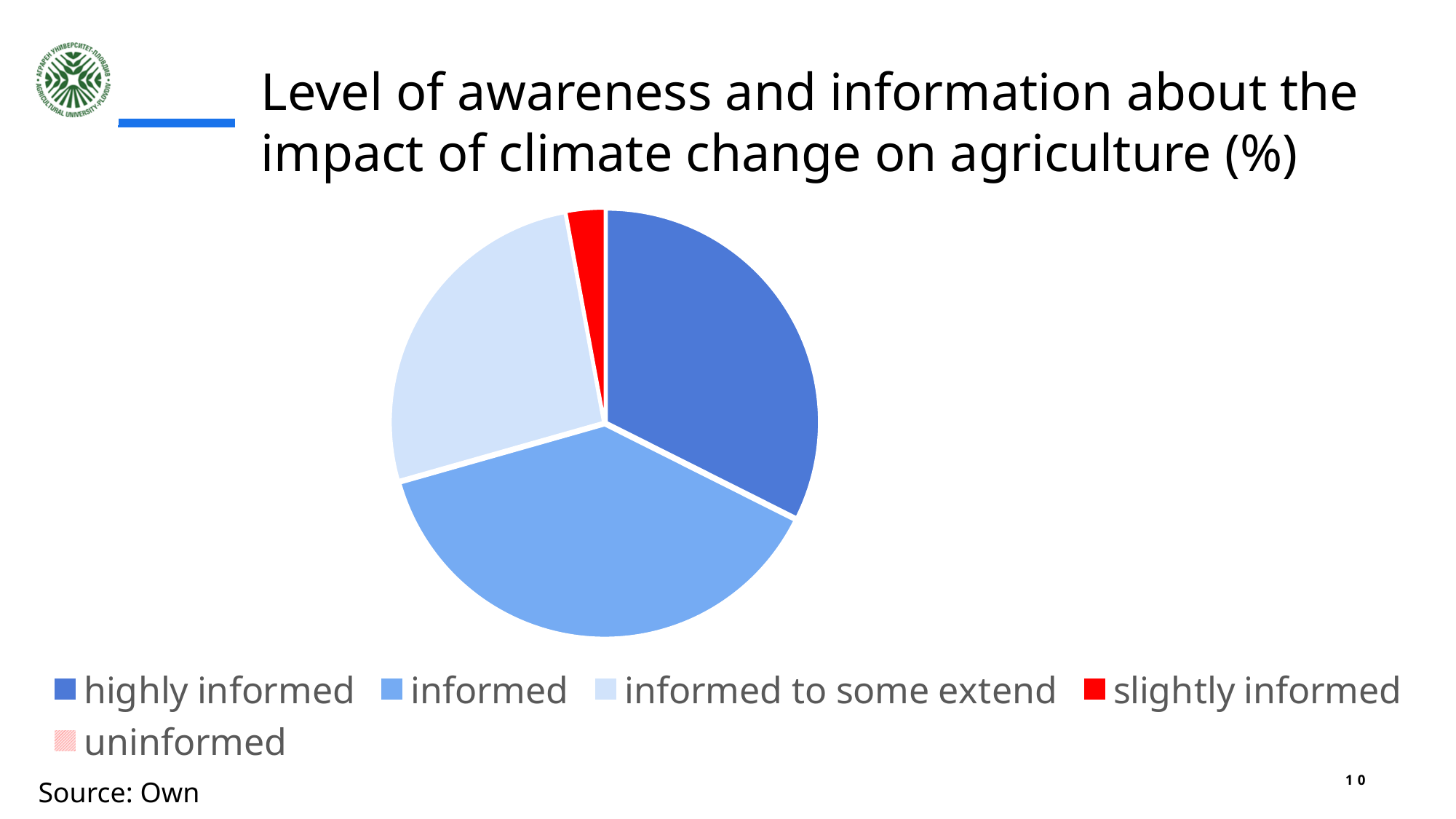
Which is larger in the pie chart: the 'informed' slice or the 'informed to some extend' slice? informed How many categories does the legend of the pie chart list? 5 What is the title of the chart? Level of awareness and information about the impact of climate change on agriculture (%) Which of the visible slices in the pie chart is the smallest? slightly informed Which colour represents the 'slightly informed' category in the pie chart? red What is the source given for the chart? Own Which is larger in the pie chart: the 'informed to some extend' slice or the 'slightly informed' slice? informed to some extend What kind of chart is shown on the slide? pie chart Which is larger in the pie chart: the 'highly informed' slice or the 'slightly informed' slice? highly informed